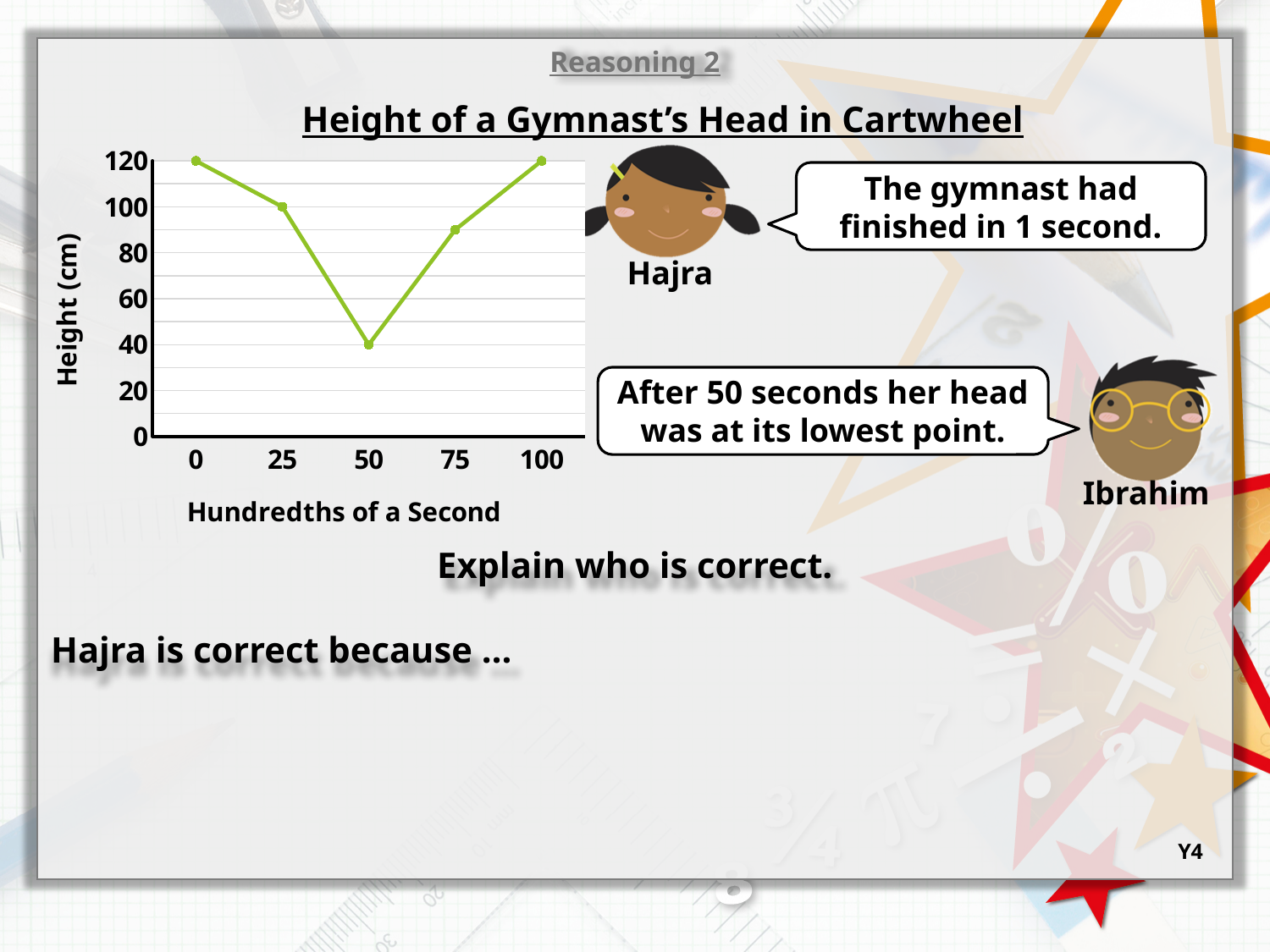
Is the height at 75 hundredths of a second greater or less than 80? greater At which time (in hundredths of a second) is the height of the gymnast's head lowest? 50 How many data points are plotted on the line? 5 What is the height of the gymnast's head at 0 hundredths of a second? 120 What is the height of the gymnast's head at 100 hundredths of a second? 120 What is the difference in height between 0 and 50 hundredths of a second? 80 What kind of chart is shown on the slide? line chart What is the height of the gymnast's head at 50 hundredths of a second? 40 Which time has the greater height, 25 or 50 hundredths of a second? 25 What is the label on the vertical axis of the chart? Height (cm) What is the height of the gymnast's head at 25 hundredths of a second? 100 Does the height rise or fall between 0 and 50 hundredths of a second? fall